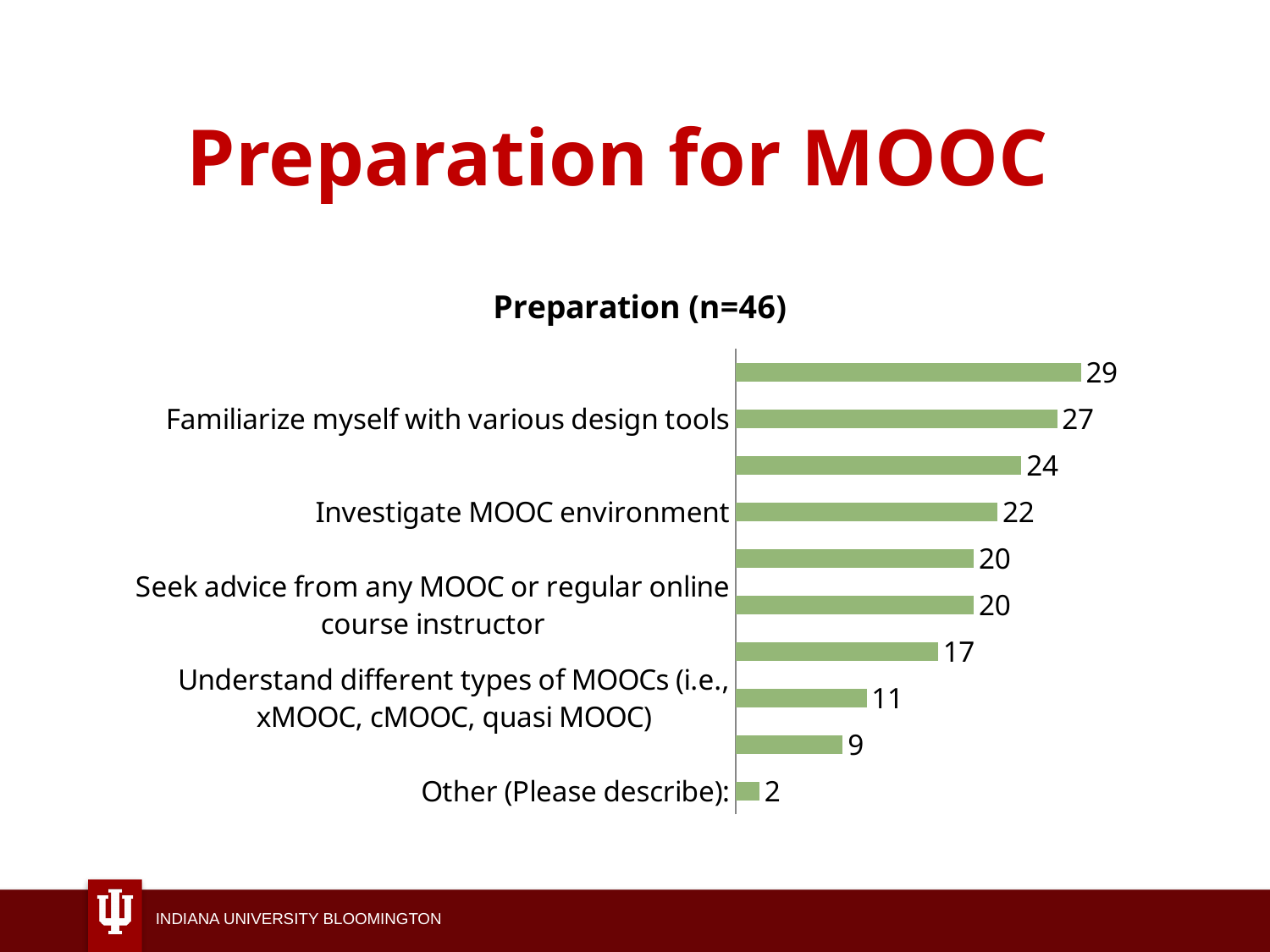
What is the highest value shown on the chart? 29 Which is larger: the value for "Investigate MOOC environment" or the value for "Understand different types of MOOCs (i.e., xMOOC, cMOOC, quasi MOOC)"? Investigate MOOC environment What is the value for "Familiarize myself with various design tools"? 27 How many bars are plotted on the chart? 10 What kind of chart is shown on the slide? Bar chart What is the value for "Understand different types of MOOCs (i.e., xMOOC, cMOOC, quasi MOOC)"? 11 What is the value for "Seek advice from any MOOC or regular online course instructor"? 20 What is the title of the chart? Preparation (n=46) What is the difference between the values for "Familiarize myself with various design tools" and "Investigate MOOC environment"? 5 Which category has the lowest value? Other (Please describe): What is the value for "Other (Please describe):"? 2 What is the value for "Investigate MOOC environment"? 22